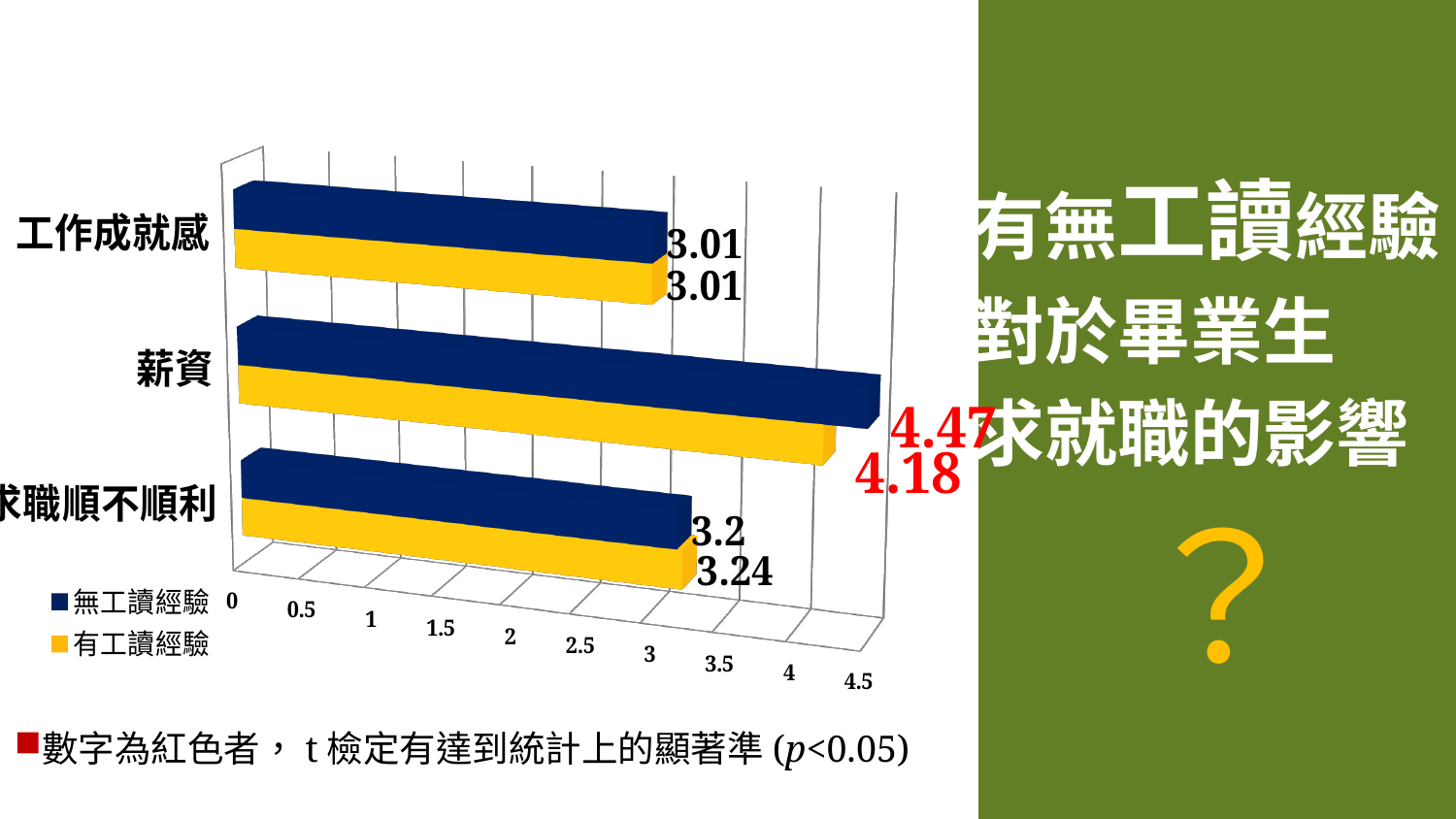
Which category has the lowest value for the 有工讀經驗 series? 工作成就感 What is the value for 有工讀經驗 in the 求職順不順利 category? 3.24 What is the value for 無工讀經驗 in the 薪資 category? 4.47 Which category has the highest value for the 無工讀經驗 series? 薪資 How many series does the legend list? 2 What kind of chart is shown on the slide? bar chart Is the value for 有工讀經驗 in the 薪資 category greater or less than 4? greater What is the value for 無工讀經驗 in the 工作成就感 category? 3.01 How many categories are shown on the chart? 3 What is the value for 有工讀經驗 in the 薪資 category? 4.18 What is the difference between the 無工讀經驗 and 有工讀經驗 values in the 薪資 category? 0.29 In the 薪資 category, which series has the larger value, 無工讀經驗 or 有工讀經驗? 無工讀經驗